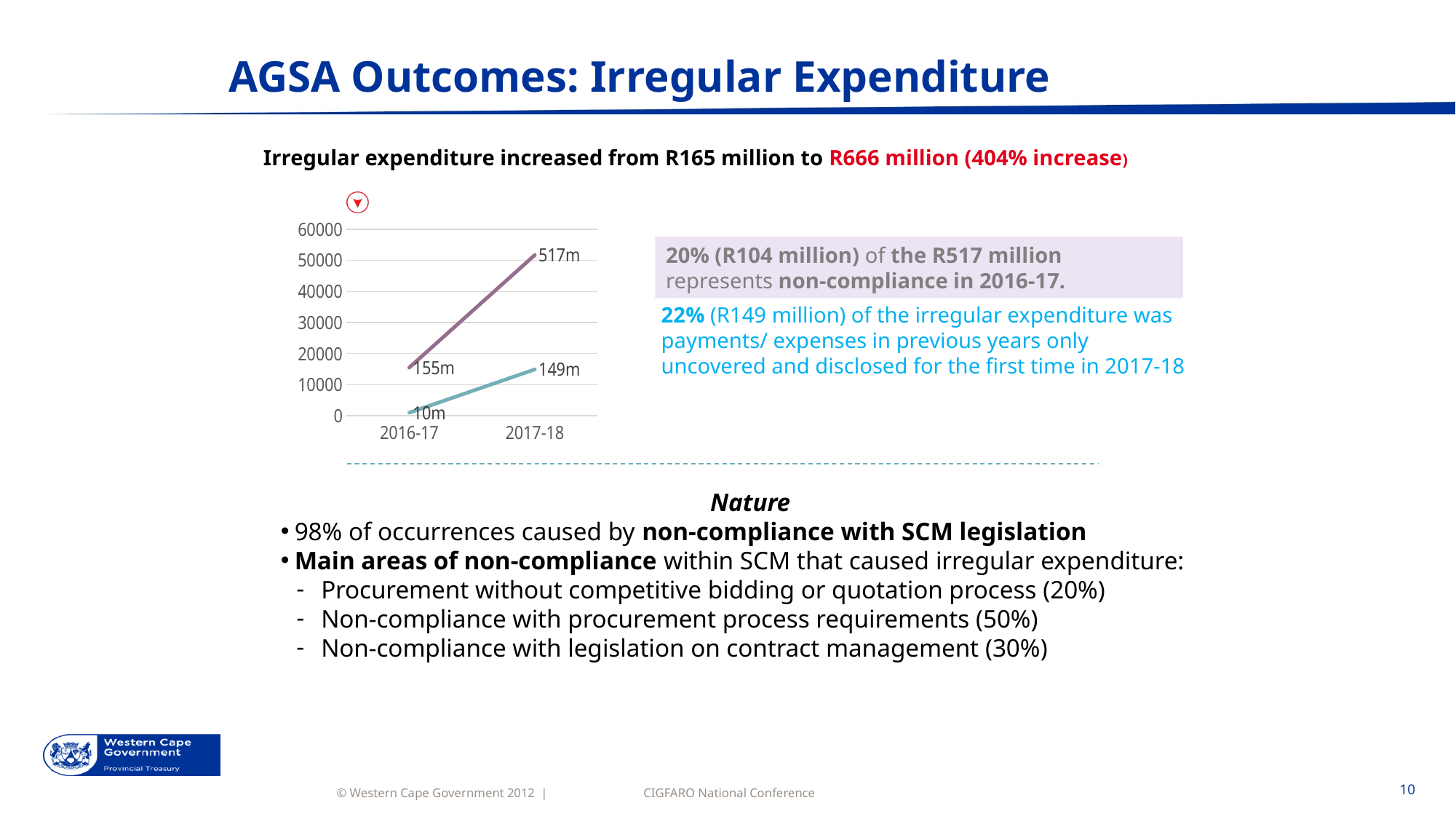
What is the data label for the teal line at 2017-18? 149m What is the data label for the purple line at 2017-18? 517m Does the teal line rise or fall from 2016-17 to 2017-18? rise Which line has the higher value at 2017-18, the purple line or the teal line? purple line Does the purple line rise or fall from 2016-17 to 2017-18? rise What is the data label for the purple line at 2016-17? 155m How many lines are plotted on the chart? 2 What is the data label for the teal line at 2016-17? 10m Which category has the lowest value on the teal line? 2016-17 What is the highest value shown on the y axis of the chart? 60000 What kind of chart is shown on the slide? line chart How many categories are shown on the x axis of the chart? 2